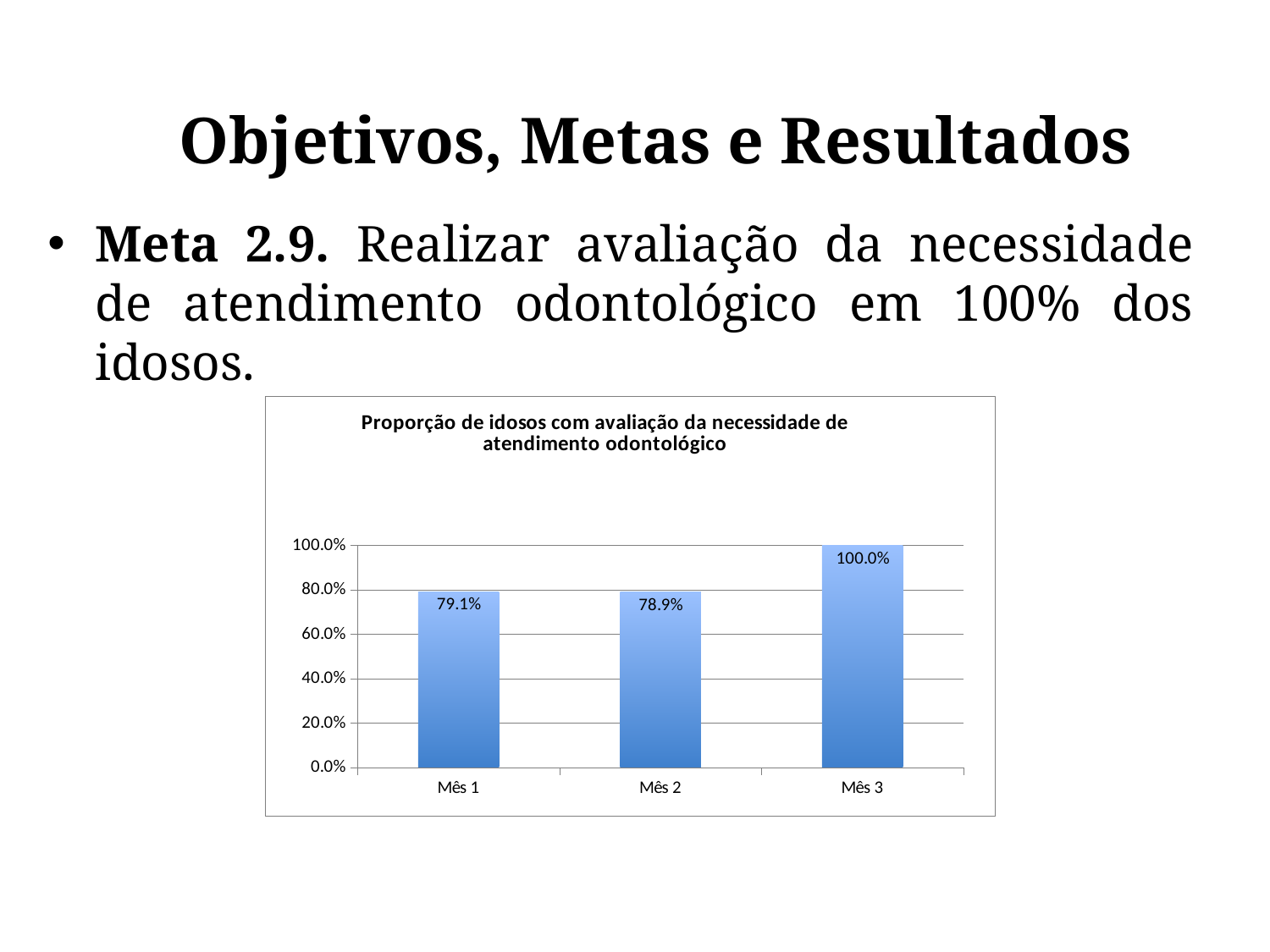
What kind of chart is shown on the slide? bar chart Which is larger, the value for Mês 3 or the value for Mês 2? Mês 3 Which month has the highest value? Mês 3 Is the value for Mês 2 greater or less than 80.0%? less What is the value for Mês 1? 79.1% Does the value rise or fall from Mês 2 to Mês 3? rise What is the title of the chart? Proporção de idosos com avaliação da necessidade de atendimento odontológico What is the value for Mês 2? 78.9% What is the value for Mês 3? 100.0% What is the difference between the values for Mês 3 and Mês 1? 20.9% What is the difference between the values for Mês 1 and Mês 2? 0.2% How many months are shown on the x axis? 3